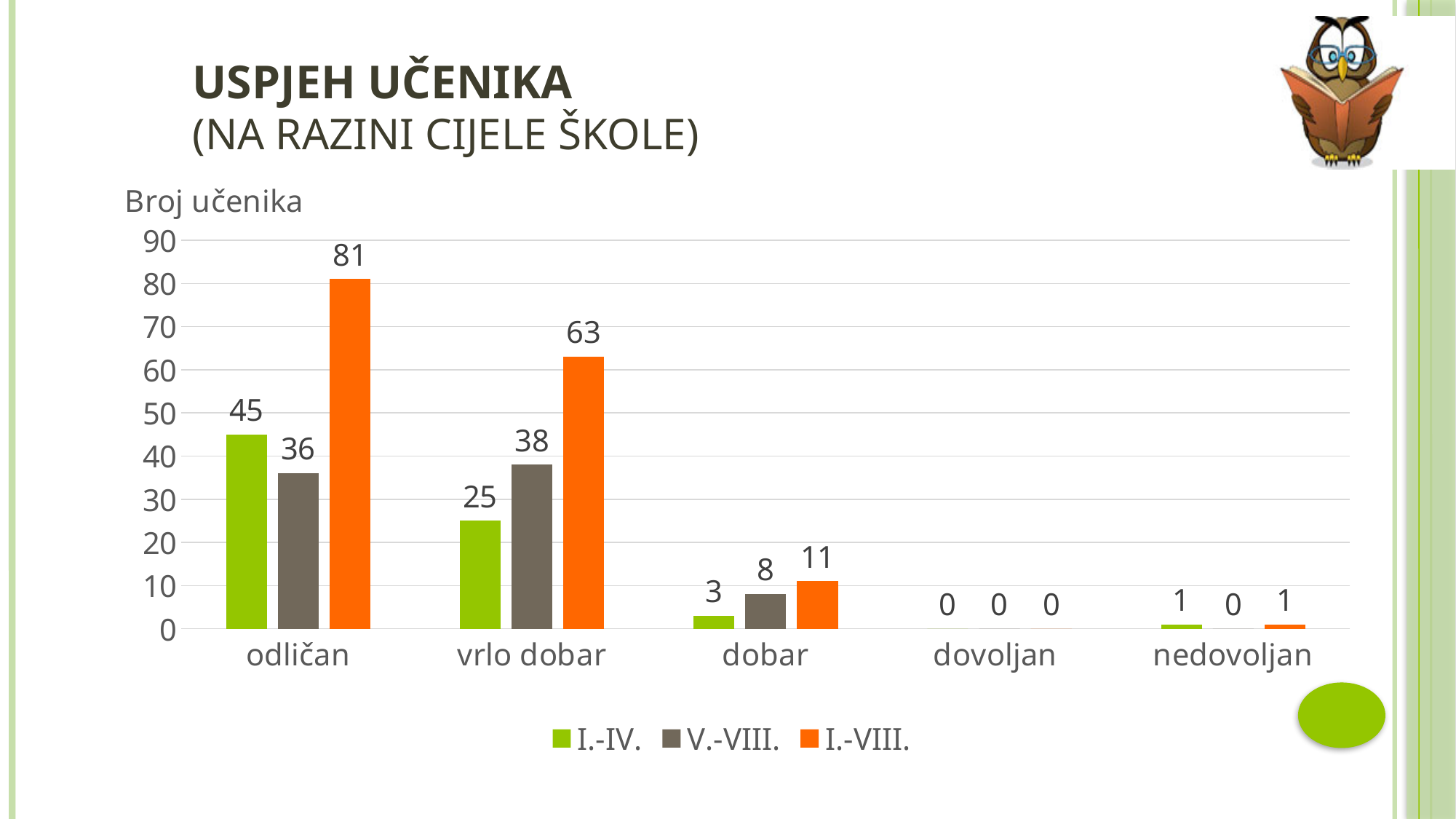
What is the value for I.-IV. in the dobar category? 3 Which is larger in the odličan category: the I.-IV. value or the V.-VIII. value? I.-IV. What is the value for V.-VIII. in the vrlo dobar category? 38 Which category has the lowest value for the V.-VIII. series? dovoljan and nedovoljan (both 0) What kind of chart is shown on the slide? bar chart How many series does the legend list? 3 What is the value for I.-VIII. in the odličan category? 81 What is the difference between the I.-VIII. values for odličan and vrlo dobar? 18 Which category has the highest value for the I.-IV. series? odličan What is the label of the vertical axis? Broj učenika Do the I.-VIII. values rise or fall from odličan to dobar along the x axis? fall How many categories are shown on the x axis? 5